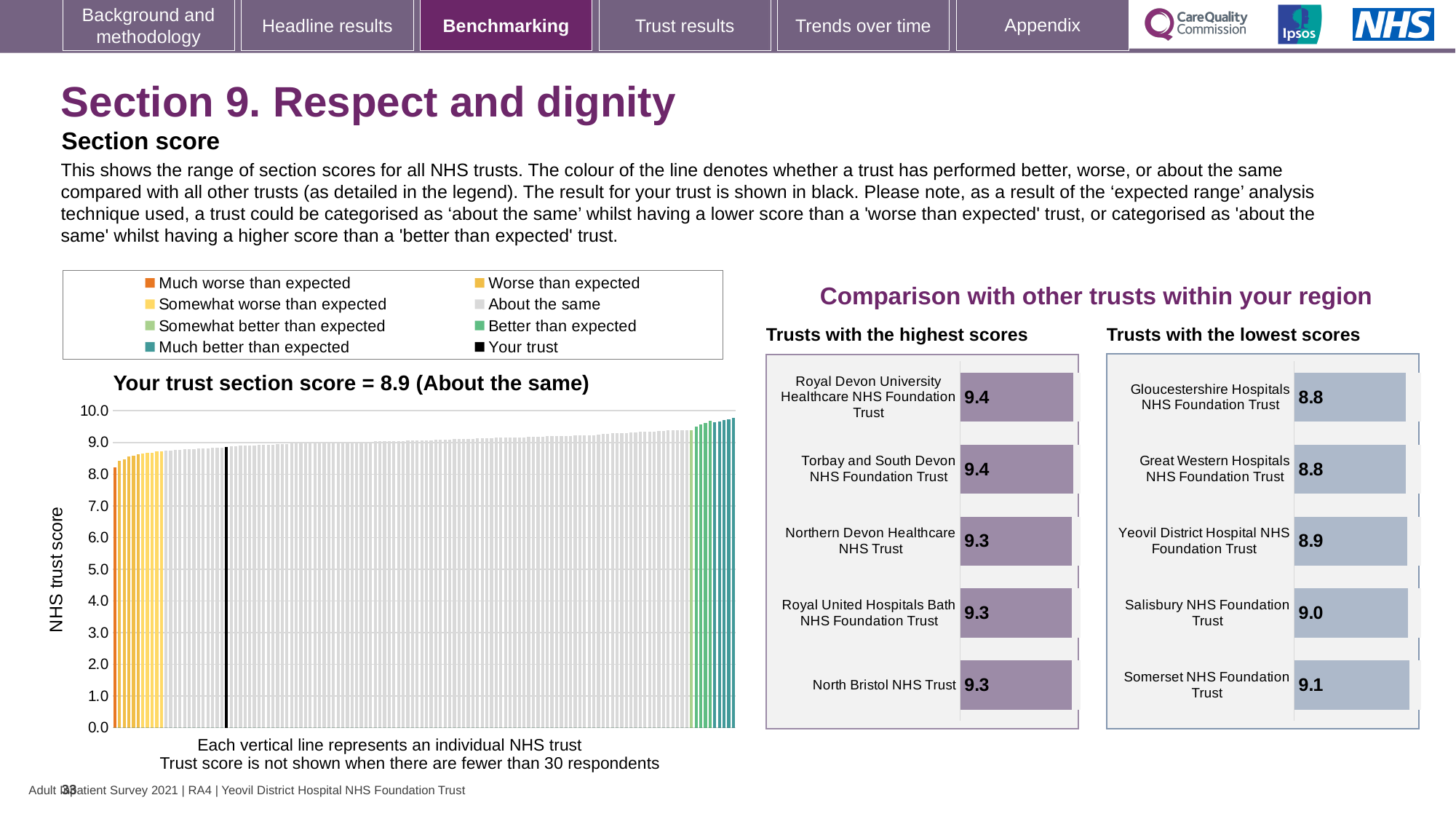
In the 'Trusts with the highest scores' chart, what is the score for North Bristol NHS Trust? 9.3 In the 'Your trust section score' chart on the left, what is the section score for your trust? 8.9 In the 'Trusts with the highest scores' chart, what is the score for Royal Devon University Healthcare NHS Foundation Trust? 9.4 How many trusts are listed in the 'Trusts with the highest scores' chart? 5 In the 'Trusts with the highest scores' chart, what is the difference between the scores of Torbay and South Devon NHS Foundation Trust and Northern Devon Healthcare NHS Trust? 0.1 In the 'Your trust section score' chart on the left, do the trust scores rise or fall from left to right? rise In the 'Trusts with the lowest scores' chart, what is the score for Yeovil District Hospital NHS Foundation Trust? 8.9 In the 'Trusts with the lowest scores' chart, which trust has the highest score? Somerset NHS Foundation Trust In the 'Trusts with the lowest scores' chart, what is the difference between the scores of Somerset NHS Foundation Trust and Yeovil District Hospital NHS Foundation Trust? 0.2 How many entries does the legend above the 'Your trust section score' chart list? 8 In the 'Your trust section score' chart on the left, is the value of the leftmost bar greater or less than 9.0? less In the 'Trusts with the lowest scores' chart, which has the larger score: Salisbury NHS Foundation Trust or Gloucestershire Hospitals NHS Foundation Trust? Salisbury NHS Foundation Trust